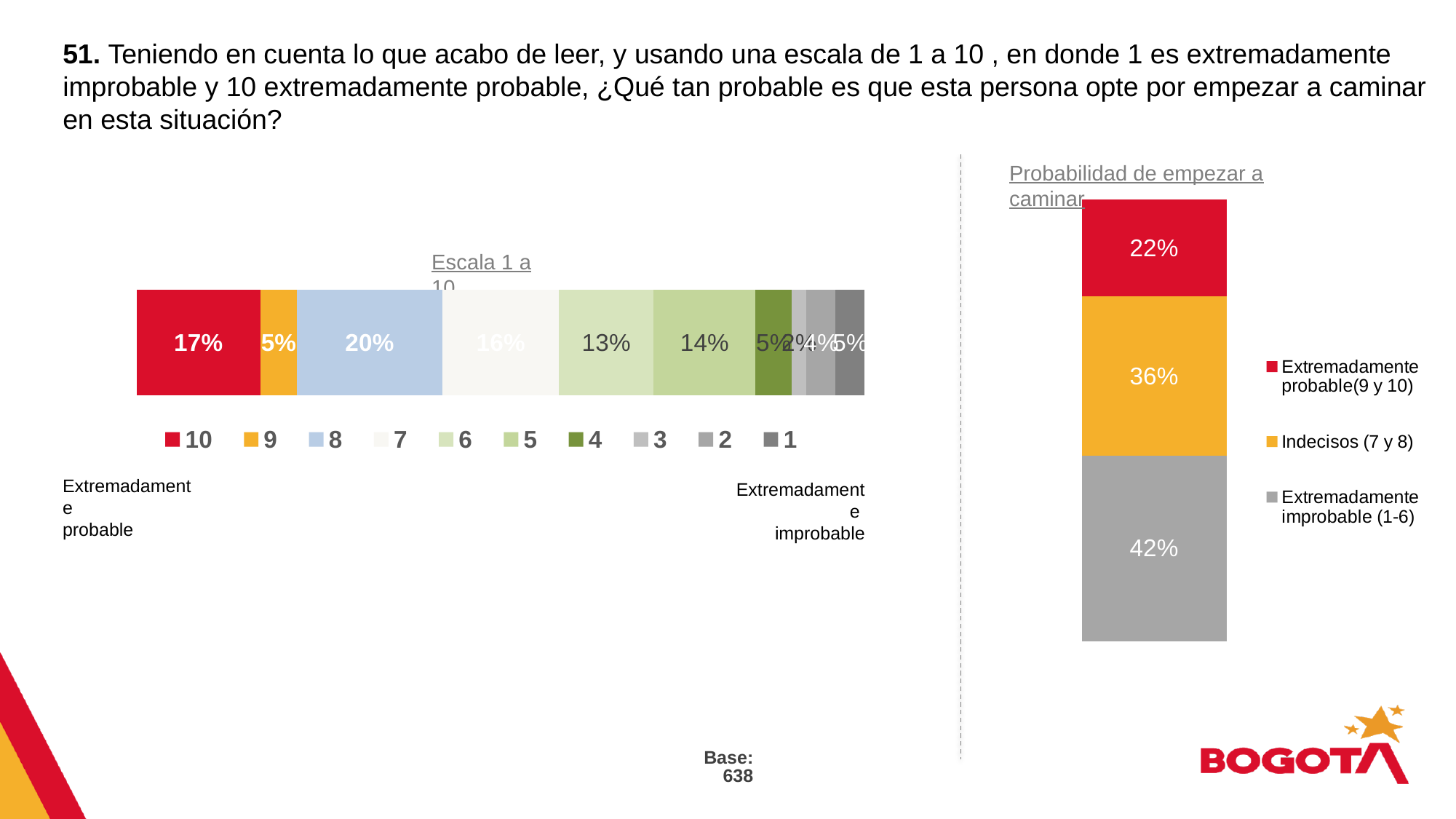
In the chart titled 'Probabilidad de empezar a caminar', what is the difference between 'Extremadamente improbable (1-6)' and 'Extremadamente probable (9 y 10)'? 20 percentage points In the chart titled 'Probabilidad de empezar a caminar', what is the total of the stacked bar? 100% In the chart titled 'Probabilidad de empezar a caminar', which segment has the highest value? Extremadamente improbable (1-6) In the chart titled 'Probabilidad de empezar a caminar', how many series does the legend list? 3 In the chart titled 'Escala 1 a 10', how many series does the legend list? 10 In the chart titled 'Escala 1 a 10', what is the value for the segment labelled 7? 16% In the chart titled 'Probabilidad de empezar a caminar', what is the value for 'Extremadamente improbable (1-6)'? 42% In the chart titled 'Escala 1 a 10', what is the value for the segment labelled 10? 17% In the chart titled 'Probabilidad de empezar a caminar', what is the value for 'Extremadamente probable (9 y 10)'? 22% In the chart titled 'Escala 1 a 10', which is larger, the value for 5 or the value for 6? 5 In the chart titled 'Escala 1 a 10', what is the value for the segment labelled 8? 20% In the chart titled 'Probabilidad de empezar a caminar', what is the value for 'Indecisos (7 y 8)'? 36%